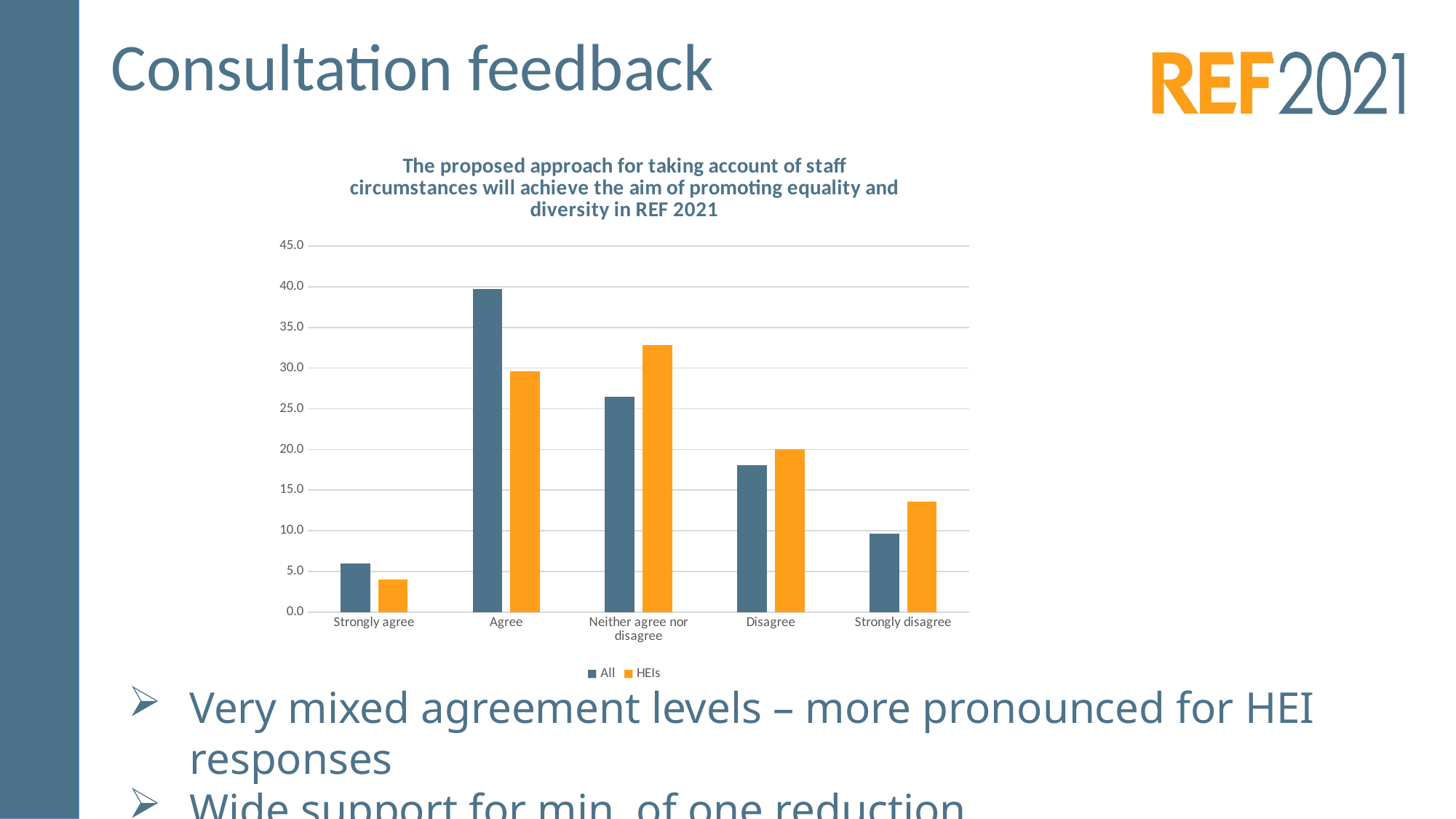
For the Agree category, which series has the larger value, All or HEIs? All What kind of chart is shown on the slide? Bar chart Which category has the lowest value for the HEIs series? Strongly agree How many series does the legend list? 2 Which category has the highest value for the All series? Agree How many response categories are shown on the x axis? 5 Which category has the lowest value for the All series? Strongly agree Is the value for HEIs in the Strongly agree category greater or less than 5.0? less For the Neither agree nor disagree category, which series has the larger value, All or HEIs? HEIs Is the value for All in the Agree category greater or less than 35.0? greater Which category has the highest value for the HEIs series? Neither agree nor disagree Which colour represents the HEIs series in the legend? Orange